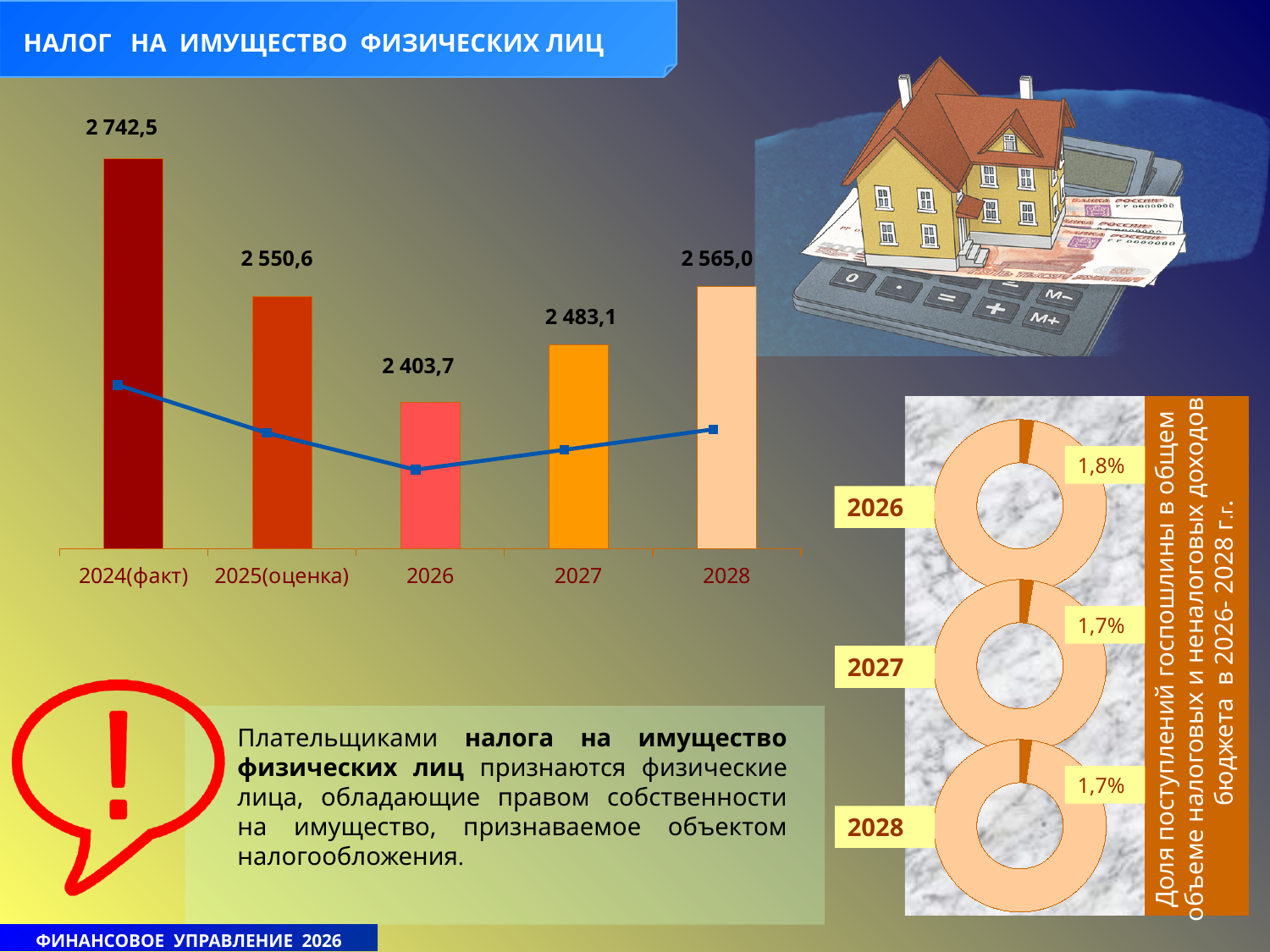
In the bar chart on the left, what is the difference between the values for 2024(факт) and 2026? 338,8 In the donut charts on the right, what share is shown for 2027? 1,7% In the bar chart on the left, which category has the lowest value? 2026 How many categories are shown on the x axis of the bar chart on the left? 5 In the bar chart on the left, what is the value for 2024(факт)? 2 742,5 In the donut charts on the right, what share is shown for 2026? 1,8% In the bar chart on the left, what is the value for 2026? 2 403,7 In the bar chart on the left, what is the difference between the values for 2028 and 2027? 81,9 In the bar chart on the left, which category has the highest value? 2024(факт) In the bar chart on the left, which is larger: the value for 2025(оценка) or the value for 2028? 2028 In the bar chart on the left, what is the value for 2028? 2 565,0 In the bar chart on the left, do the values rise or fall from 2026 to 2028? rise